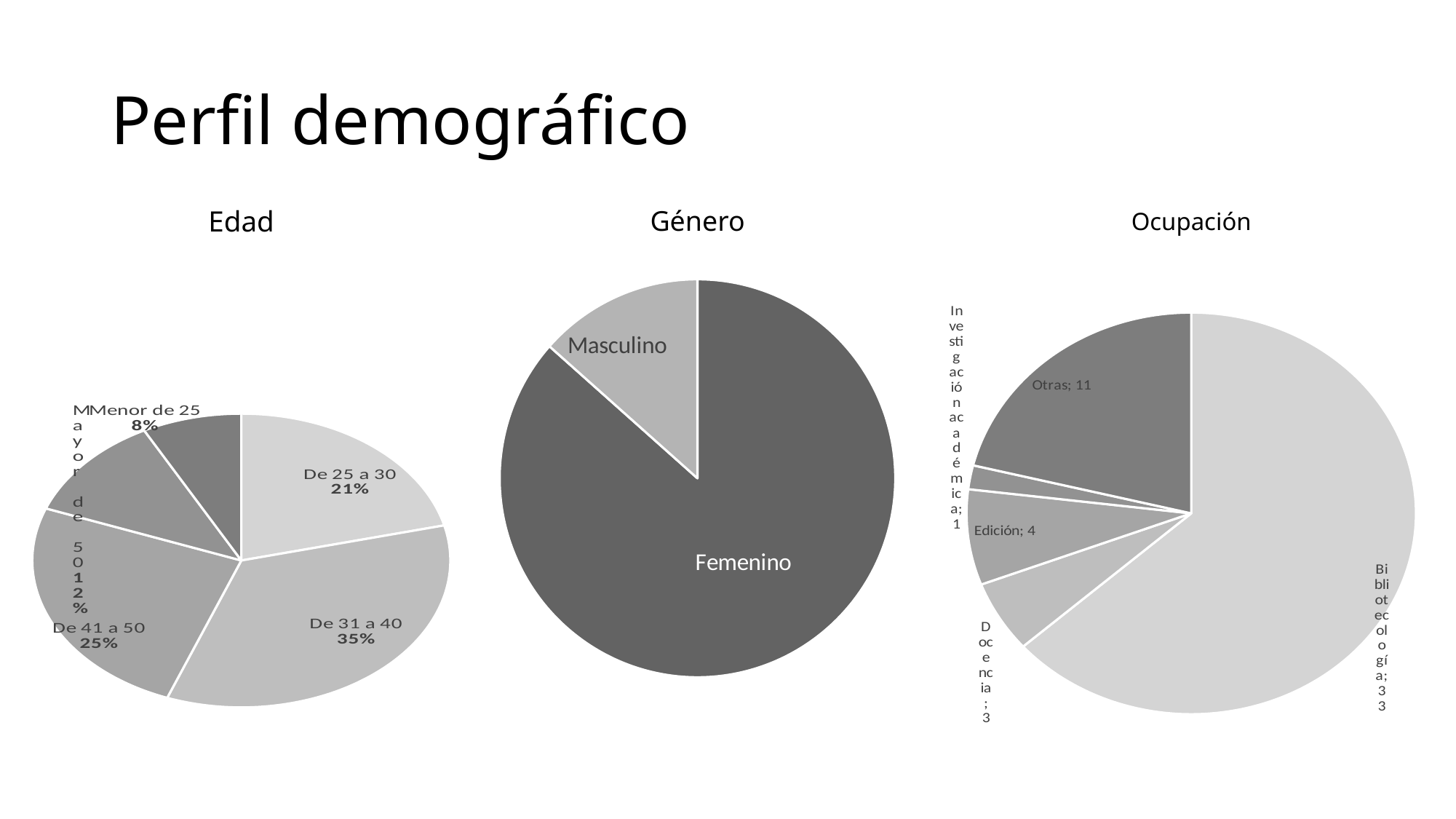
What kind of chart is the Género chart? pie chart On the Edad chart, which age group has the largest share? De 31 a 40 On the Edad chart, which age group has the smallest share? Menor de 25 On the Edad chart, how many age groups are shown? 5 On the Ocupación chart, what is the difference between Bibliotecología and Otras? 22 On the Ocupación chart, what is the value for Otras? 11 On the Ocupación chart, what is the value for Edición? 4 On the Edad chart, what is the difference in percentage points between De 41 a 50 and Menor de 25? 17 On the Ocupación chart, which occupation has the highest value? Bibliotecología On the Género chart, which category is larger, Femenino or Masculino? Femenino On the Edad chart, what percentage is shown for De 25 a 30? 21% On the Edad chart, what percentage is shown for De 31 a 40? 35%